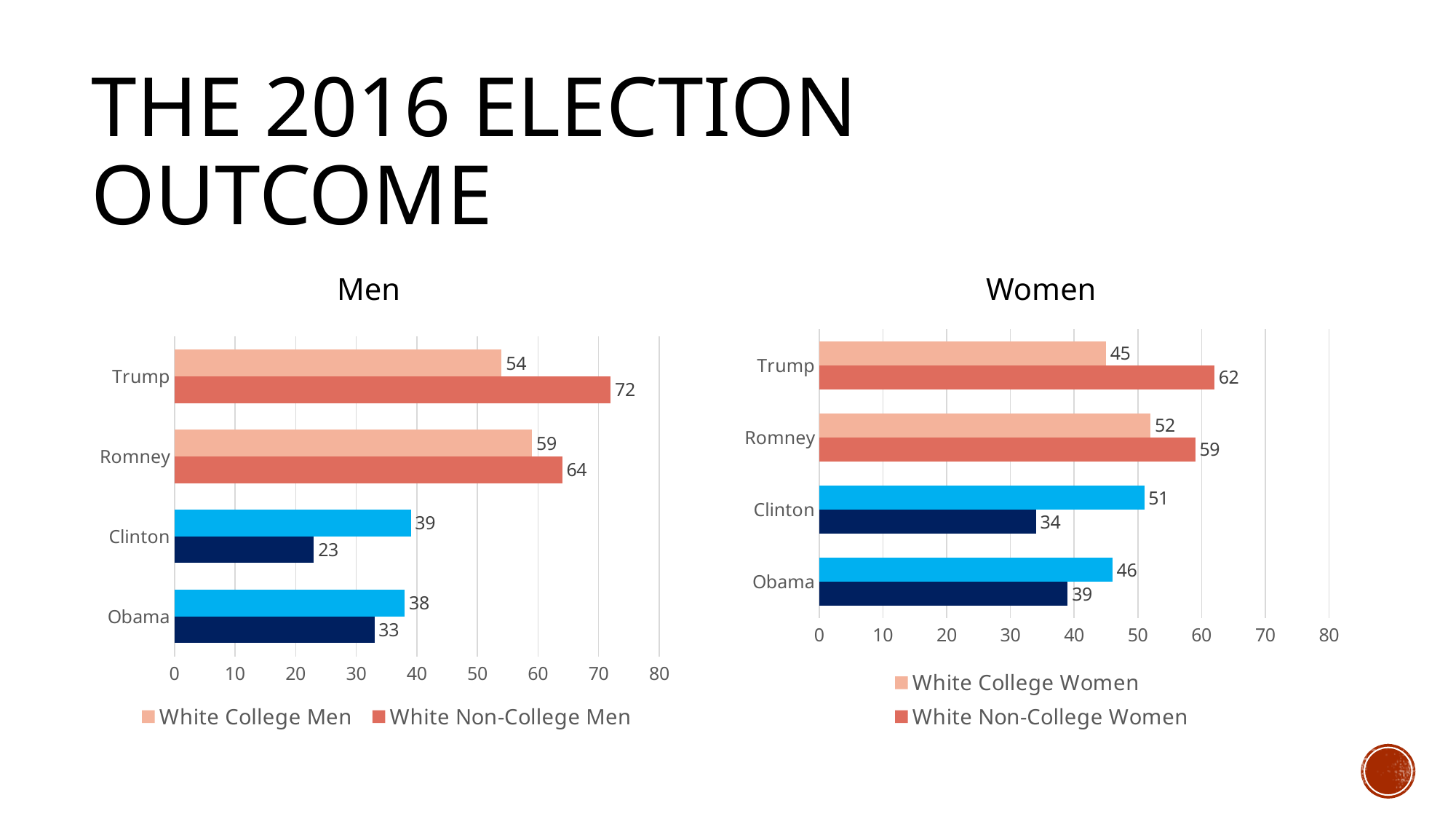
In the Men chart, what is the difference between the White Non-College Men and White College Men values for Trump? 18 How many series does the legend of the Men chart list? 2 In the Women chart, what is the difference between the White Non-College Women and White College Women values for Trump? 17 In the Men chart, which candidate has the highest single bar value? Trump In the Women chart, what is the value for White College Women for Romney? 52 In the Women chart, what is the value for White Non-College Women for Trump? 62 In the Men chart, what is the value for White College Men for Romney? 59 How many candidates are shown in the Women chart? 4 What type of chart is the Women chart? Bar chart In the Men chart, which candidate has the lowest single bar value? Clinton In the Women chart, which is larger for Romney: the White College Women value or the White Non-College Women value? White Non-College Women In the Men chart, what is the value for White Non-College Men for Trump? 72